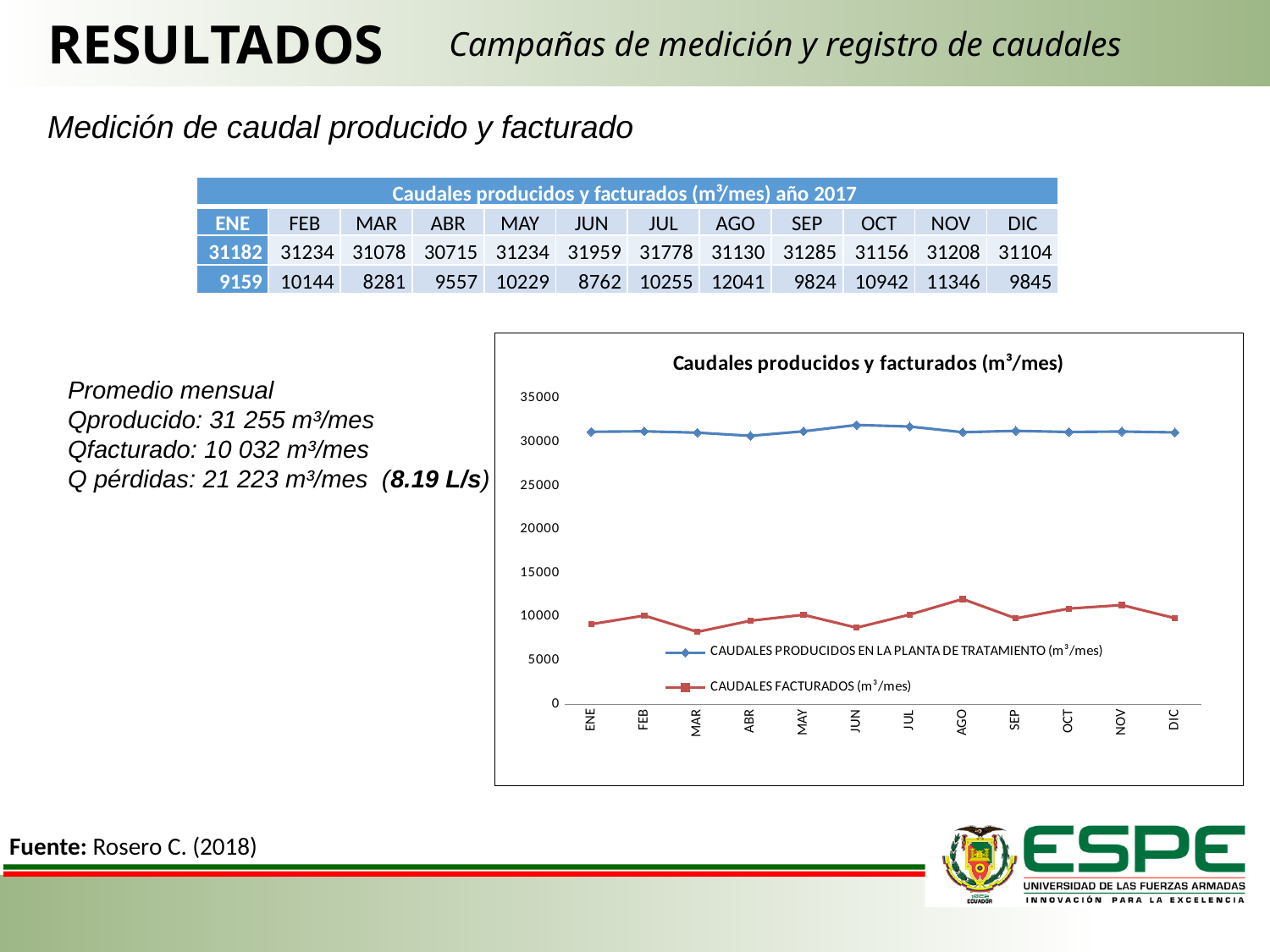
In which month is the value of CAUDALES FACTURADOS lowest? MAR Using the values printed in the table, what is the difference between the produced flow (31182) and the billed flow (9159) in ENE? 22023 What kind of chart is shown on the slide? line chart Which is larger, the CAUDALES FACTURADOS value in FEB or in MAR? FEB What is the title of the chart? Caudales producidos y facturados (m³/mes) What is the value of CAUDALES FACTURADOS in AGO, as printed in the table on the slide? 12041 Is the value of CAUDALES PRODUCIDOS EN LA PLANTA DE TRATAMIENTO in ENE greater or less than 30000? greater In which month is the value of CAUDALES FACTURADOS highest? AGO Is the value of CAUDALES FACTURADOS in MAR greater or less than 10000? less In which month is the value of CAUDALES PRODUCIDOS EN LA PLANTA DE TRATAMIENTO highest? JUN How many months are plotted along the x axis of the chart? 12 How many series does the chart legend list? 2